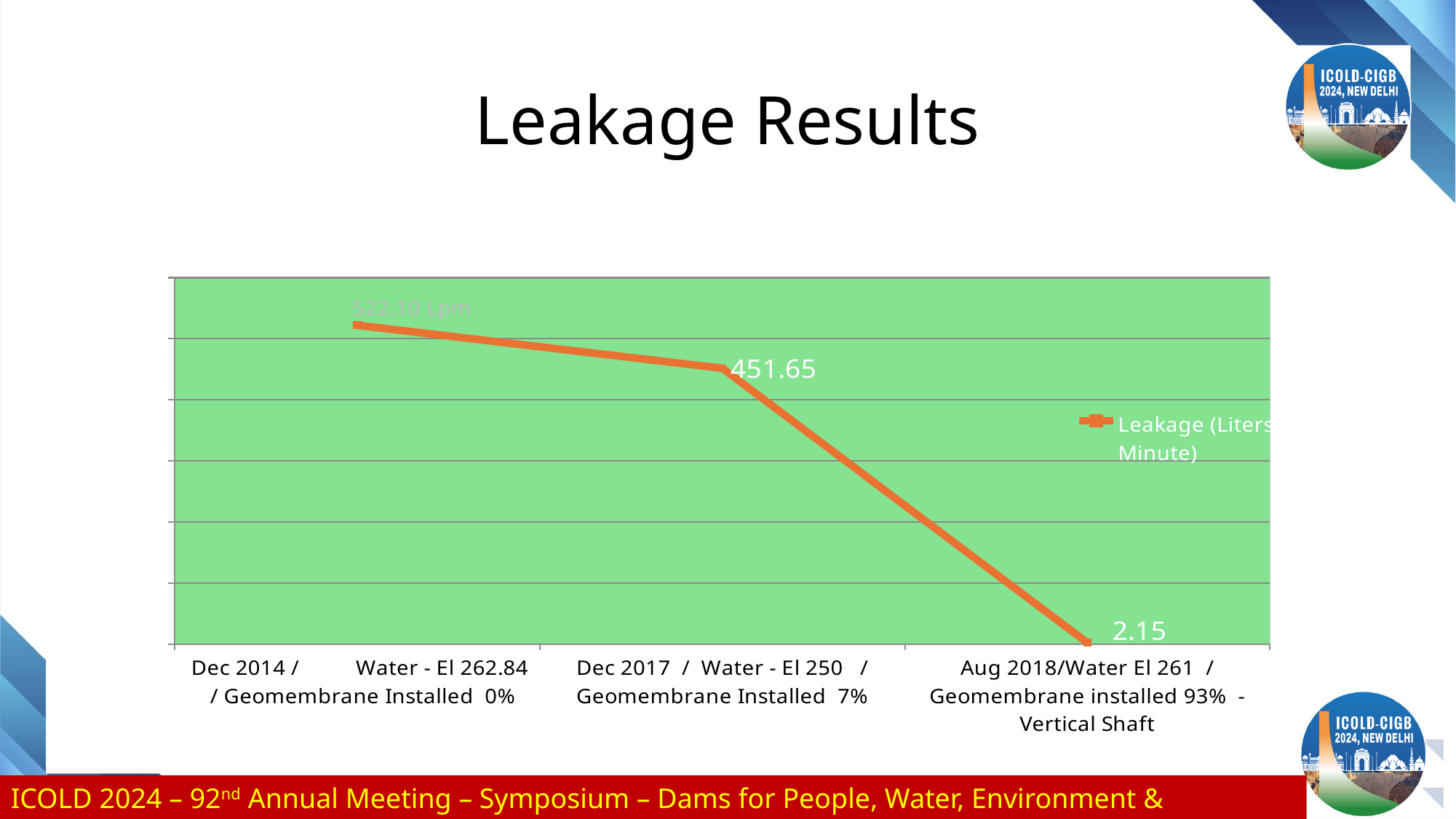
Do the leakage values rise or fall from left to right along the x axis? Fall Which point has the highest leakage value? Dec 2014 / Water - El 262.84 / Geomembrane Installed 0% What is the difference between the Dec 2017 leakage value and the Aug 2018 leakage value? 449.50 How many data points are plotted on the line? 3 What is the difference between the Dec 2014 leakage value and the Dec 2017 leakage value? 70.45 Which point has the lowest leakage value? Aug 2018/Water El 261 / Geomembrane installed 93% - Vertical Shaft What kind of chart is shown on the slide? Line chart Which is larger, the leakage value for Dec 2017 or for Aug 2018? Dec 2017 How many series does the legend list? 1 What is the leakage value for the Dec 2017 point (Geomembrane Installed 7%)? 451.65 What is the leakage value for the Aug 2018 point (Geomembrane installed 93% - Vertical Shaft)? 2.15 What is the leakage value for the Dec 2014 point (Geomembrane Installed 0%)? 522.10 Lpm